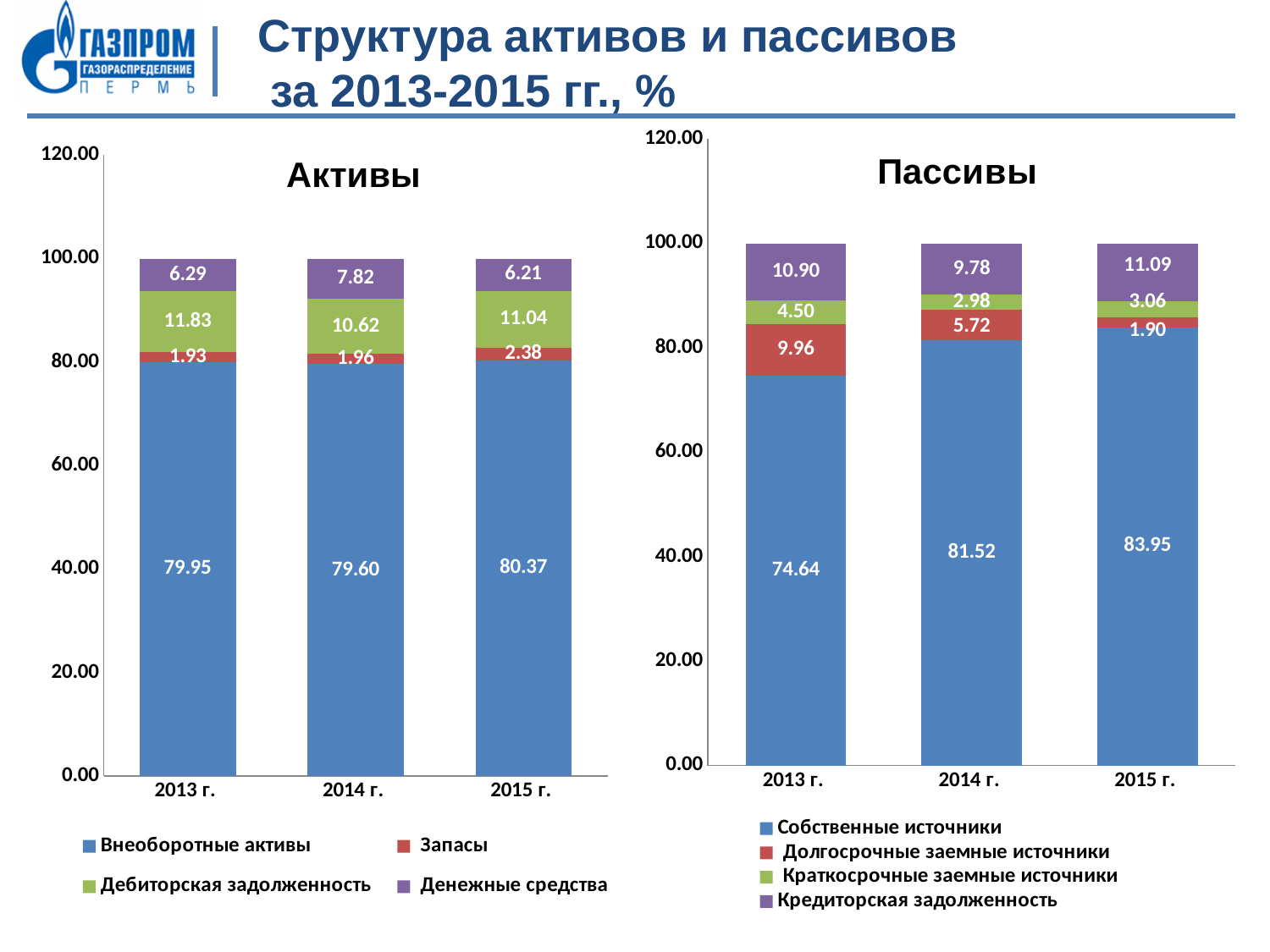
In the 'Активы' chart, what is the value of 'Внеоборотные активы' for 2015 г.? 80.37 What kind of chart is the 'Активы' chart? stacked bar chart In the 'Пассивы' chart, what is the difference between 'Долгосрочные заемные источники' in 2013 г. and 2015 г.? 8.06 In the 'Пассивы' chart, what is the value of 'Кредиторская задолженность' for 2015 г.? 11.09 How many years are shown on the x axis of the 'Активы' chart? 3 In the 'Активы' chart, which is larger: 'Запасы' in 2014 г. or 'Запасы' in 2015 г.? 2015 г. In the 'Пассивы' chart, what is the value of 'Собственные источники' for 2013 г.? 74.64 How many series does the legend of the 'Пассивы' chart list? 4 In the 'Пассивы' chart, which year has the highest value for 'Собственные источники'? 2015 г. In the 'Пассивы' chart, does 'Собственные источники' for 2014 г. rise or fall compared with 2013 г.? rise In the 'Активы' chart, what is the value of 'Дебиторская задолженность' for 2014 г.? 10.62 In the 'Активы' chart, which year has the lowest value for 'Денежные средства'? 2015 г.